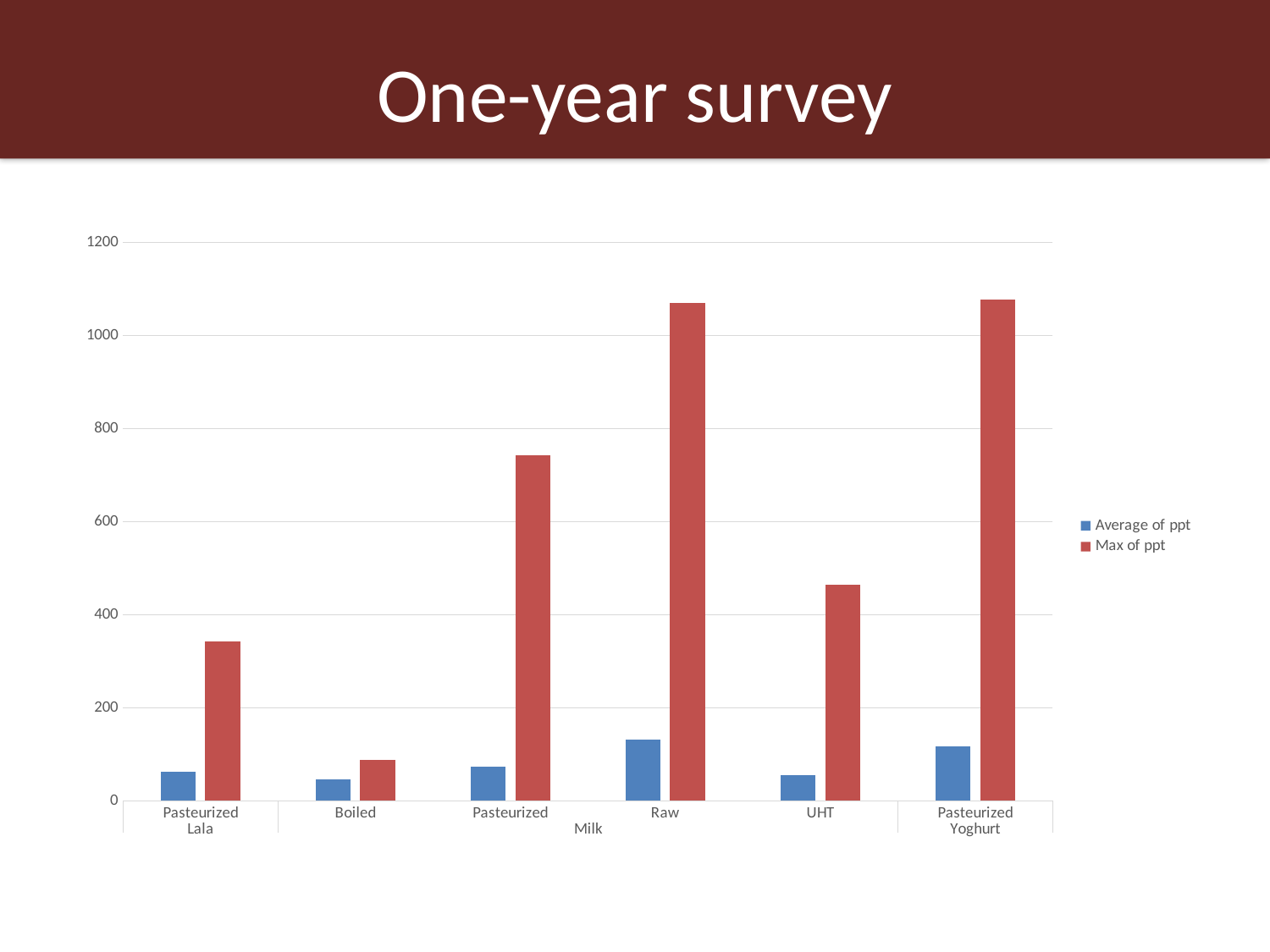
Is the Max of ppt value for UHT greater or less than 400? greater Is the Max of ppt value for Boiled greater or less than 200? less What kind of chart is shown on the slide? bar chart How many series does the legend list? 2 Which colour represents the Max of ppt series in the legend? red What is the title of the slide containing the chart? One-year survey Is the Max of ppt value for Raw greater or less than 1000? greater How many categories are shown along the x axis? 6 Which category has the lowest Max of ppt value? Boiled Which has the larger Max of ppt value, UHT or Pasteurized Lala? UHT